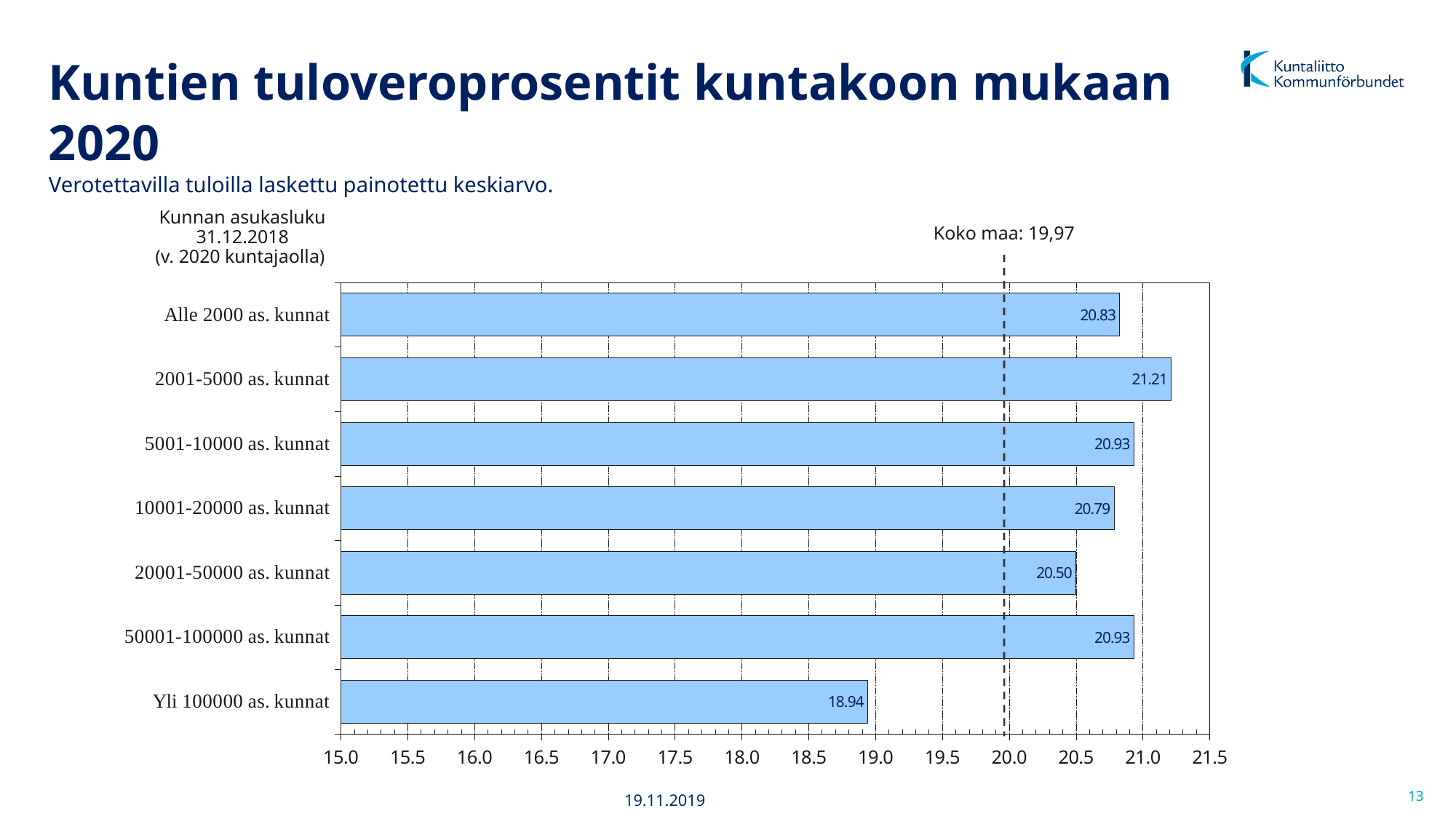
What value is given for Koko maa, marked by the dashed line? 19,97 What is the value for 2001-5000 as. kunnat? 21.21 Which is larger, the value for Alle 2000 as. kunnat or the value for 10001-20000 as. kunnat? Alle 2000 as. kunnat Which category has the highest value? 2001-5000 as. kunnat What kind of chart is shown on the slide? bar chart What is the value for Yli 100000 as. kunnat? 18.94 What is the value for 20001-50000 as. kunnat? 20.50 What is the difference between the values for 2001-5000 as. kunnat and Yli 100000 as. kunnat? 2.27 Is the value for Yli 100000 as. kunnat greater or less than 19.0? less How many categories are shown in the chart? 7 Which category has the lowest value? Yli 100000 as. kunnat What is the difference between the values for 5001-10000 as. kunnat and 20001-50000 as. kunnat? 0.43